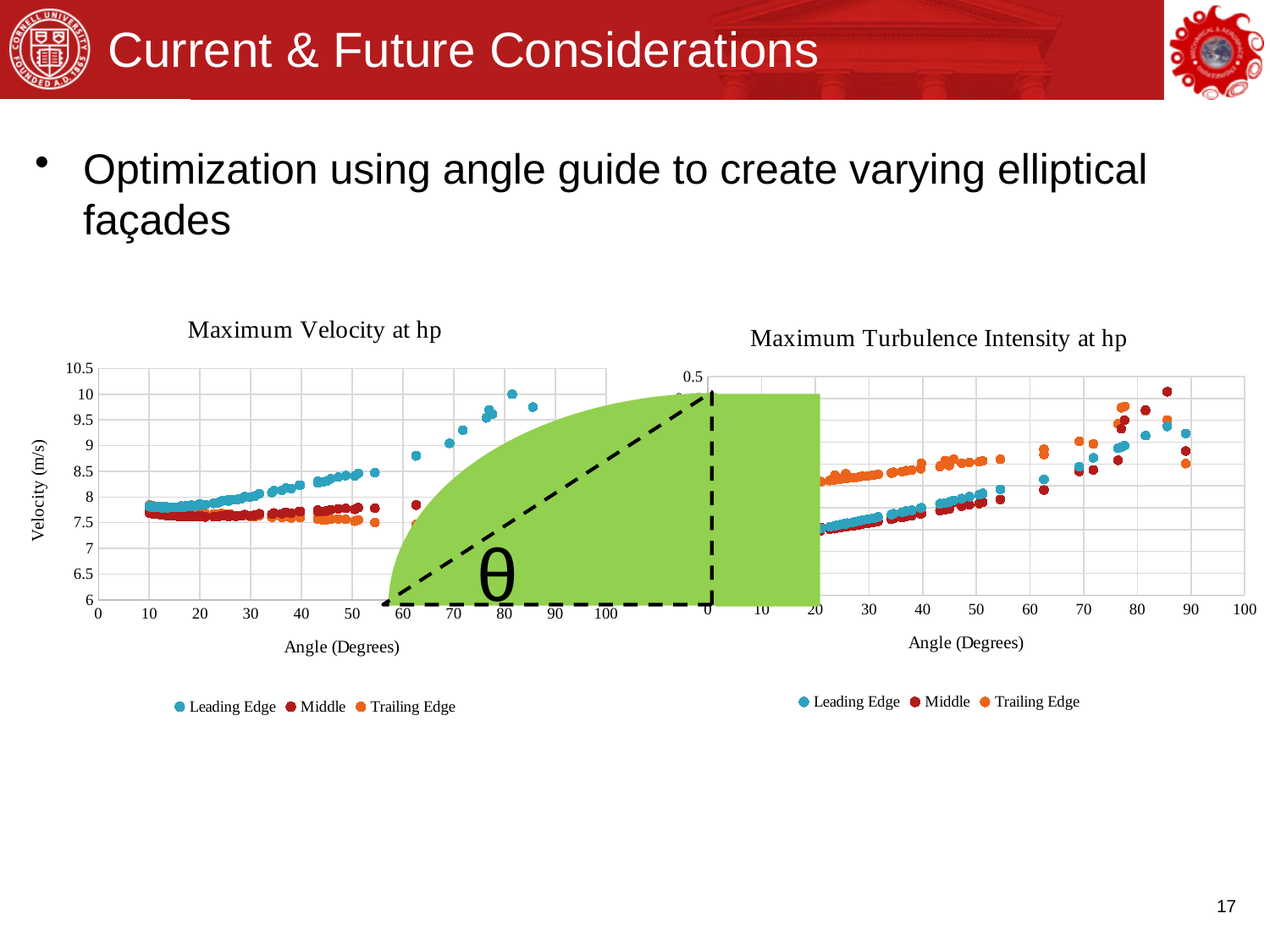
In the "Maximum Velocity at hp" chart, is the Middle value at about 40 degrees greater or less than 8? less In the "Maximum Velocity at hp" chart, is the Leading Edge value at about 80 degrees greater or less than 9.5? greater In the "Maximum Turbulence Intensity at hp" chart, which series has the higher value at about 40 degrees, Trailing Edge or Leading Edge? Trailing Edge In the "Maximum Velocity at hp" chart, is the Trailing Edge value at about 50 degrees greater or less than 8? less What is the x-axis label of the "Maximum Turbulence Intensity at hp" chart? Angle (Degrees) How many series does the legend of the "Maximum Velocity at hp" chart list? 3 What is the y-axis label of the "Maximum Velocity at hp" chart? Velocity (m/s) What kind of chart is the "Maximum Velocity at hp" chart? scatter chart In the "Maximum Velocity at hp" chart, which series has the higher value at about 60 degrees, Leading Edge or Middle? Leading Edge In the "Maximum Velocity at hp" chart, does the Leading Edge series rise or fall as the angle increases? rise In the "Maximum Turbulence Intensity at hp" chart, do the values generally rise or fall as the angle increases? rise